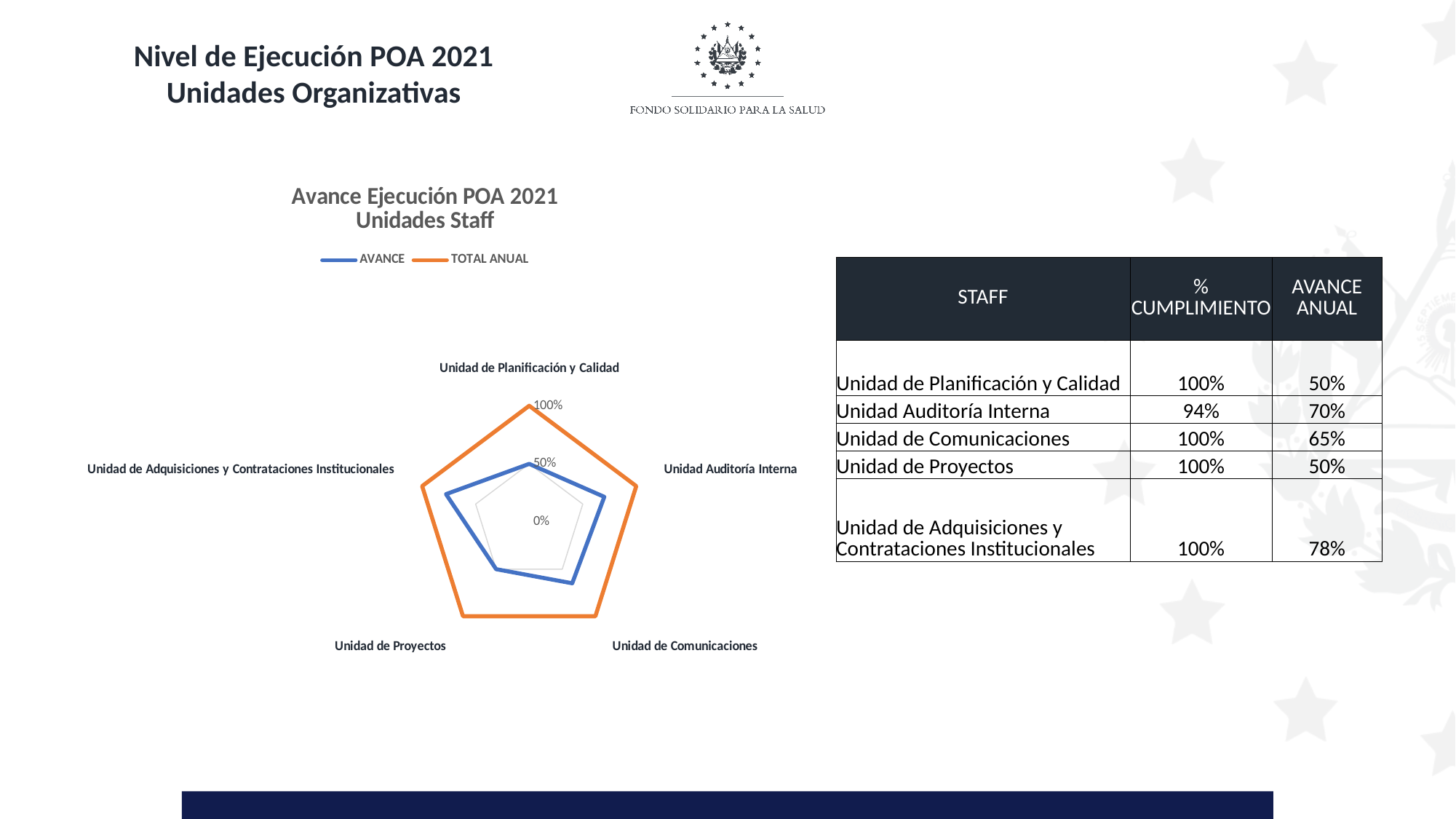
Which series in the radar chart is drawn in orange? TOTAL ANUAL According to the table, what is the % CUMPLIMIENTO for Unidad Auditoría Interna? 94% What is the difference in AVANCE ANUAL between Unidad de Adquisiciones y Contrataciones Institucionales and Unidad de Planificación y Calidad? 28% According to the table, what is the AVANCE ANUAL for Unidad de Adquisiciones y Contrataciones Institucionales? 78% What kind of chart is shown under the title "Avance Ejecución POA 2021 Unidades Staff"? Radar chart What is the title of the radar chart? Avance Ejecución POA 2021 Unidades Staff Which has a larger AVANCE ANUAL, Unidad Auditoría Interna or Unidad de Comunicaciones? Unidad Auditoría Interna Which unit has the highest AVANCE ANUAL value? Unidad de Adquisiciones y Contrataciones Institucionales How many categories (units) are plotted on the radar chart? 5 On the radar chart, is the AVANCE value for Unidad de Adquisiciones y Contrataciones Institucionales greater or less than 50%? greater According to the table, what is the AVANCE ANUAL for Unidad Auditoría Interna? 70% How many series does the legend of the radar chart list? 2